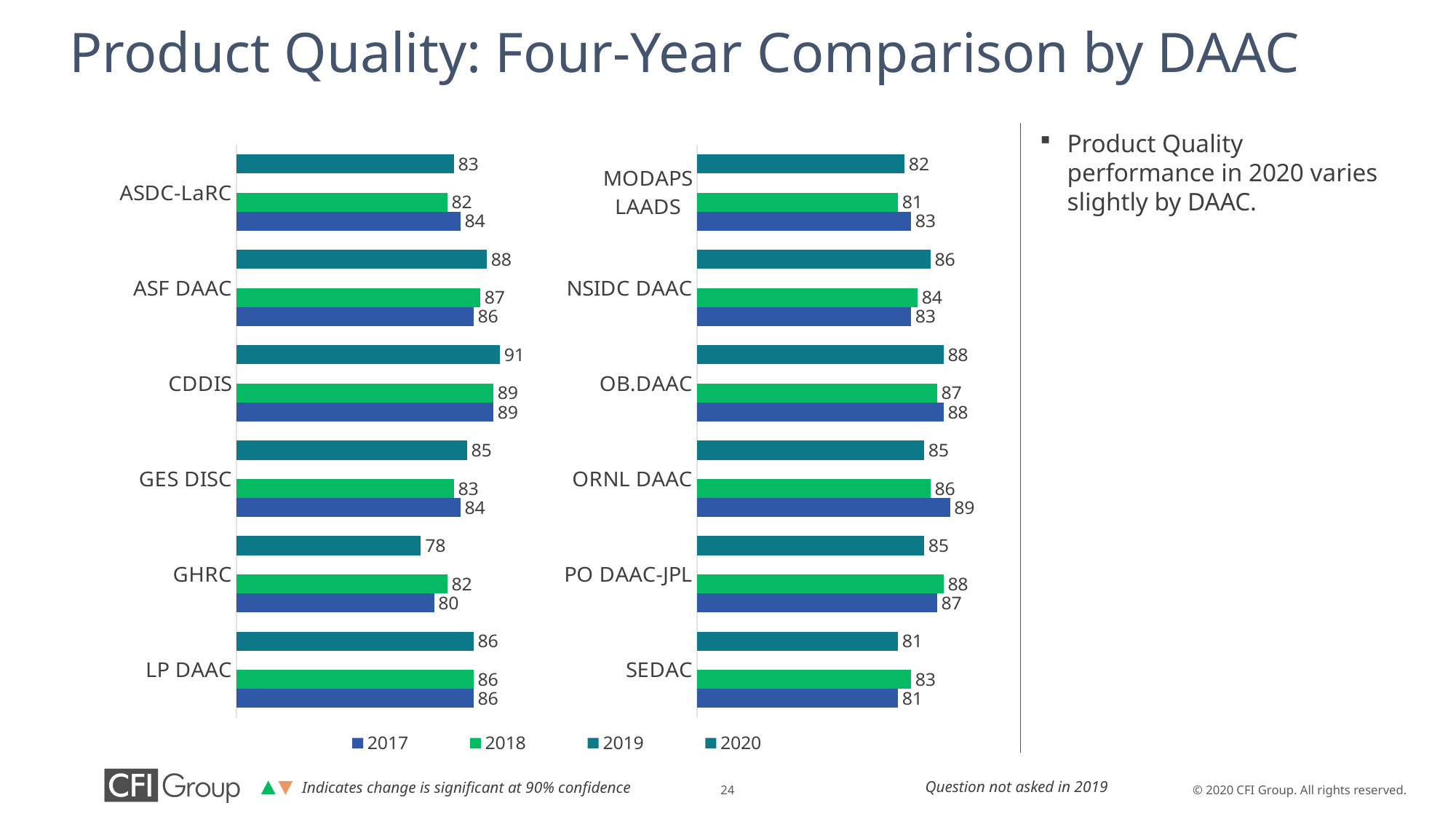
What type of chart is used on this slide? Bar chart In the right chart, which DAAC has the highest 2020 value? OB.DAAC In the left chart, what is the 2020 value for CDDIS? 91 In the left chart, what is the difference between the 2020 and 2017 values for ASF DAAC? 2 In the left chart, which DAAC has the highest 2020 value? CDDIS In the right chart, what is the 2017 value for ORNL DAAC? 89 In the left chart, what is the 2018 value for GHRC? 82 How many DAACs are shown in the right chart? 6 In the right chart, what is the 2020 value for SEDAC? 81 In the right chart, which is larger for PO DAAC-JPL: the 2018 value or the 2020 value? 2018 In the left chart, which DAAC has the lowest 2020 value? GHRC How many years does the legend list? 4